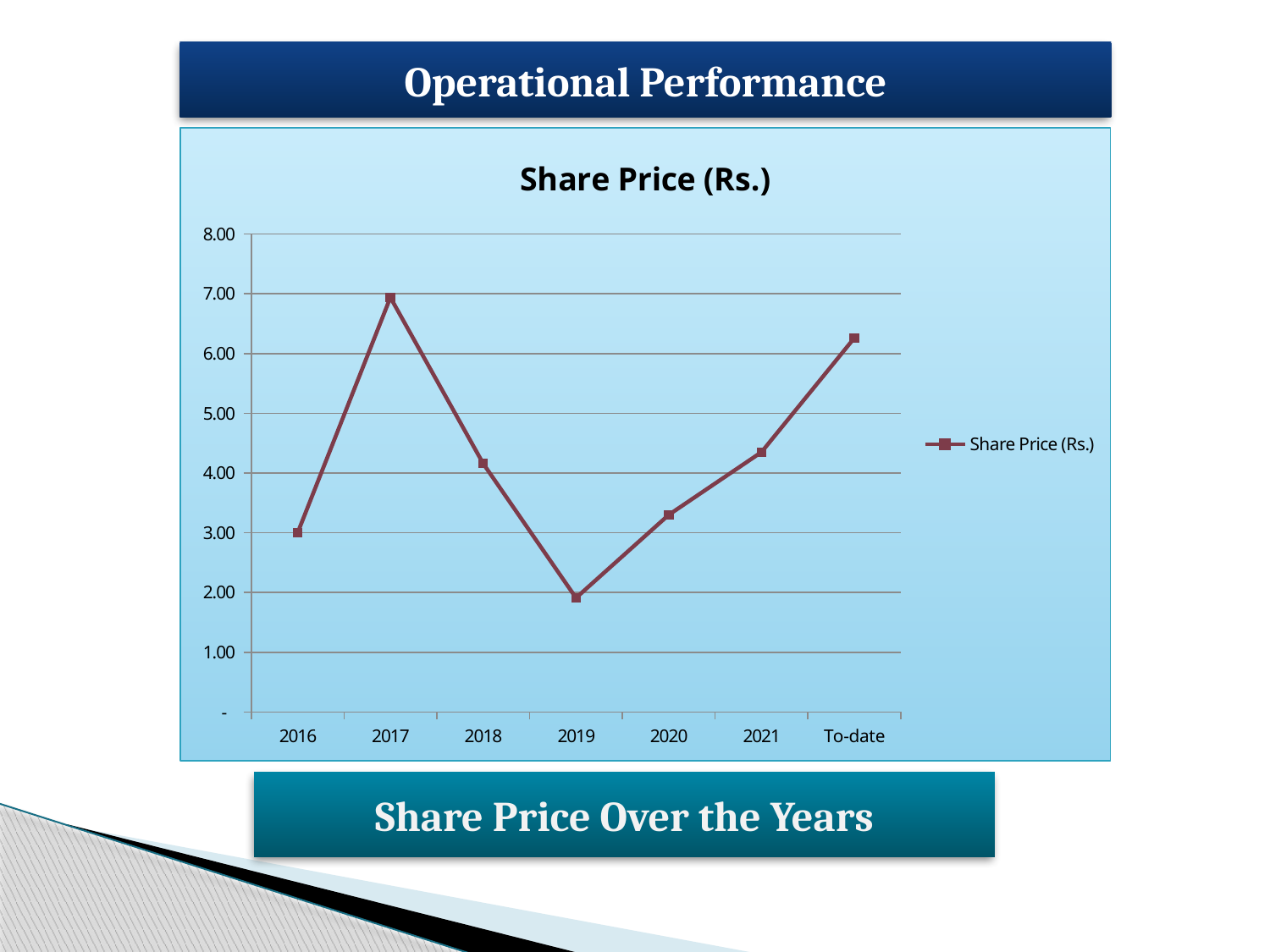
How many points are plotted along the x axis of the Share Price (Rs.) chart? 7 How many series does the legend of the Share Price (Rs.) chart list? 1 Which year has the highest share price in the chart? 2017 Does the share price rise or fall from 2019 to To-date? rise Is the share price for 2021 greater or less than 5.00? less What is the title of the chart on the slide? Share Price (Rs.) Is the share price for To-date greater or less than 6.00? greater Is the share price for 2017 greater or less than 6.00? greater Which is larger, the share price for 2017 or for To-date? 2017 What kind of chart is shown on the slide? line chart Which year has the lowest share price in the chart? 2019